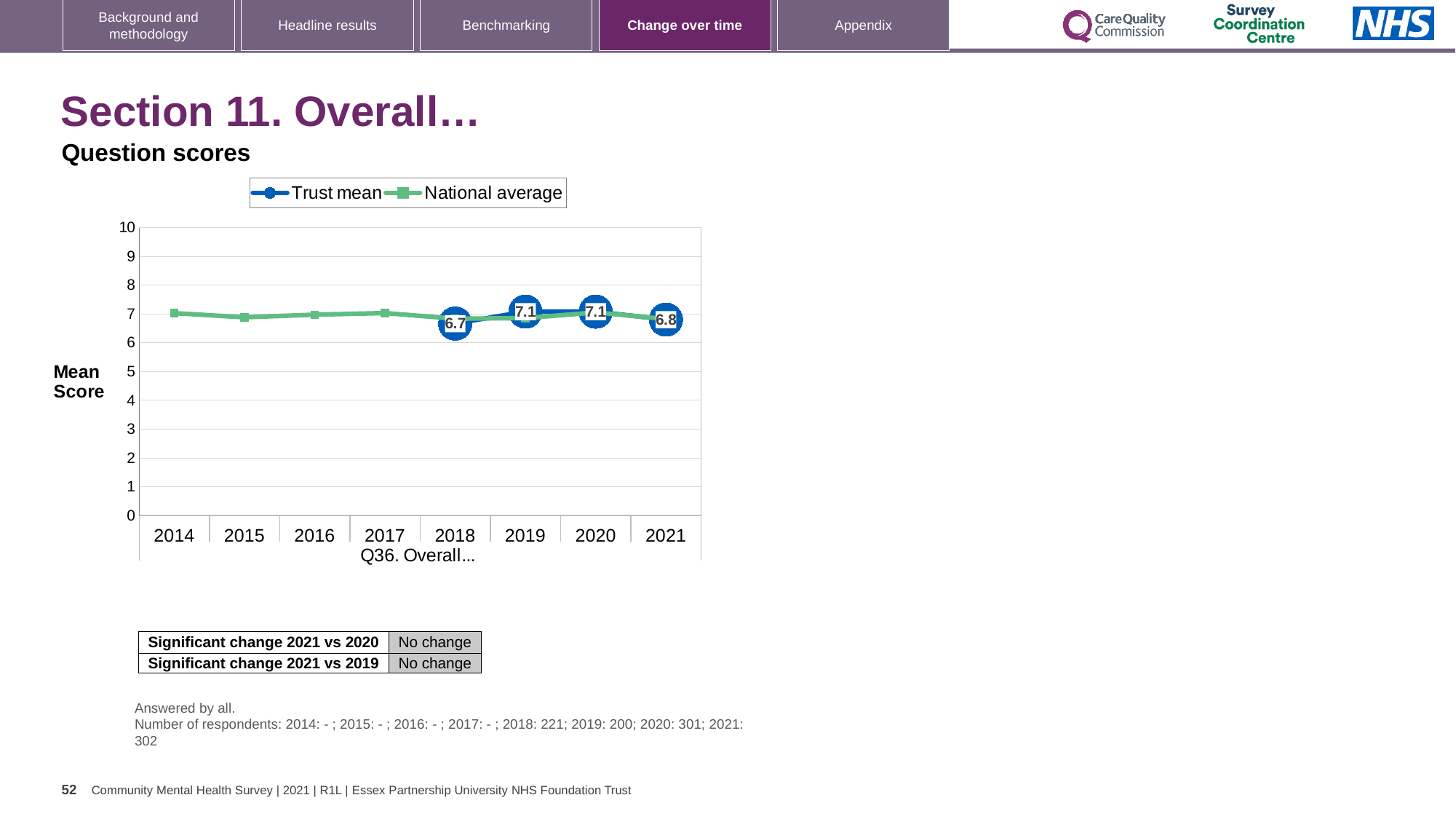
How many series does the legend list? 2 What is the Trust mean value for 2019? 7.1 What is the Trust mean value for 2018? 6.7 What is the Trust mean value for 2021? 6.8 What kind of chart is shown on the slide? Line chart Which is larger, the Trust mean for 2018 or for 2019? 2019 Does the Trust mean rise or fall from 2020 to 2021? Fall How many years are shown on the x axis? 8 Is the National average value for 2014 greater or less than 5? greater What is the difference between the Trust mean in 2020 and in 2021? 0.3 In which year is the Trust mean lowest? 2018 What is the difference between the Trust mean in 2019 and in 2018? 0.4